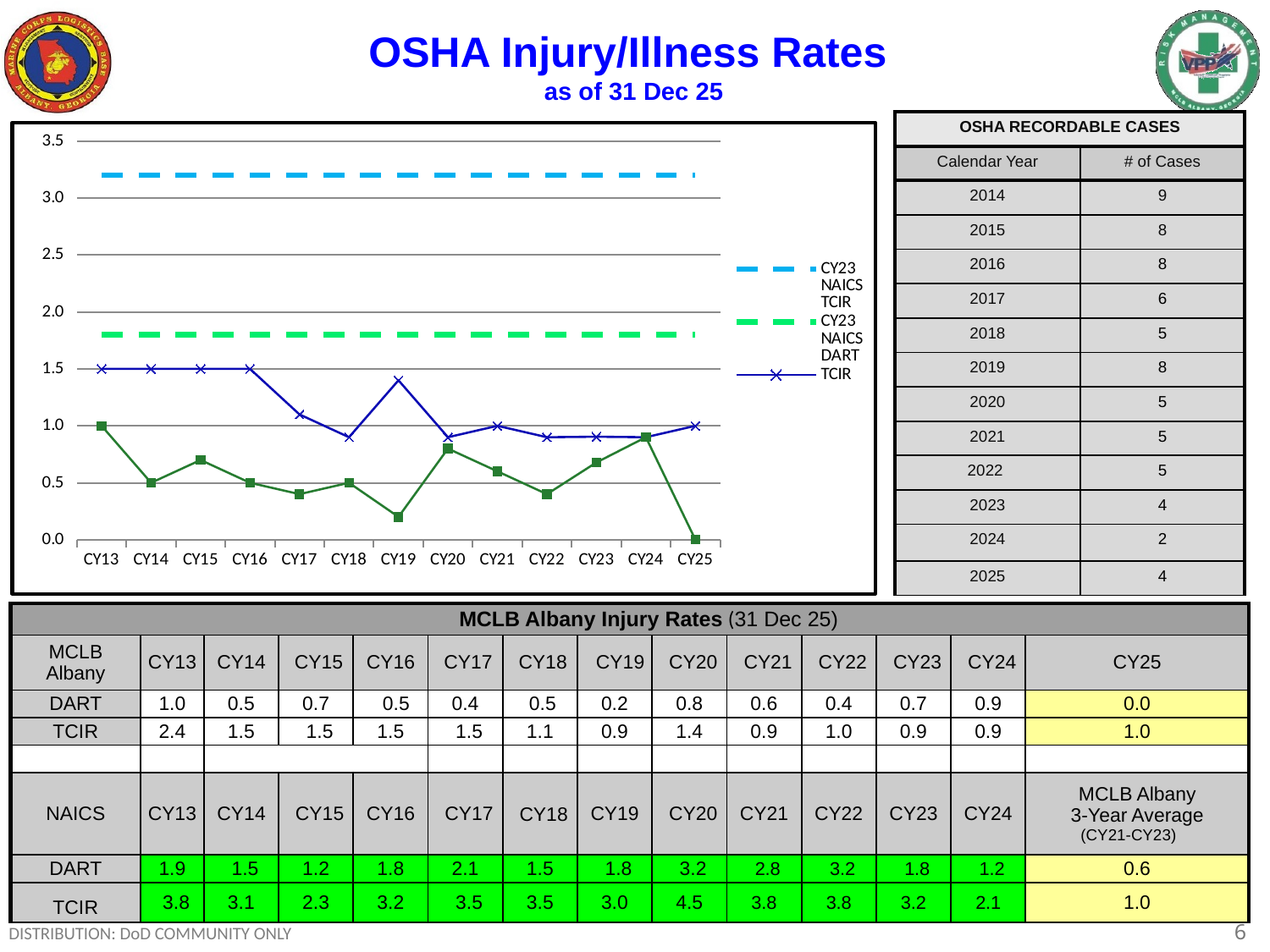
Is the CY23 NAICS DART line on the chart greater or less than 2.0? less What is the TCIR value plotted for CY25 on the chart? 1.0 How many calendar years are plotted along the x axis of the chart? 13 Which is larger at CY19 on the chart, the TCIR value or the DART value? TCIR What kind of chart is shown on the slide? line chart Is the CY23 NAICS TCIR line on the chart greater or less than 3.0? greater Does the TCIR line on the chart rise or fall overall from CY13 to CY25? fall In which calendar year does the DART line reach its lowest point on the chart? CY25 What is the TCIR value plotted for CY16 on the chart? 1.5 What is the title of the slide containing the chart? OSHA Injury/Illness Rates Is the DART value for CY19 on the chart greater or less than 0.5? less What is the DART value plotted for CY25 on the chart? 0.0